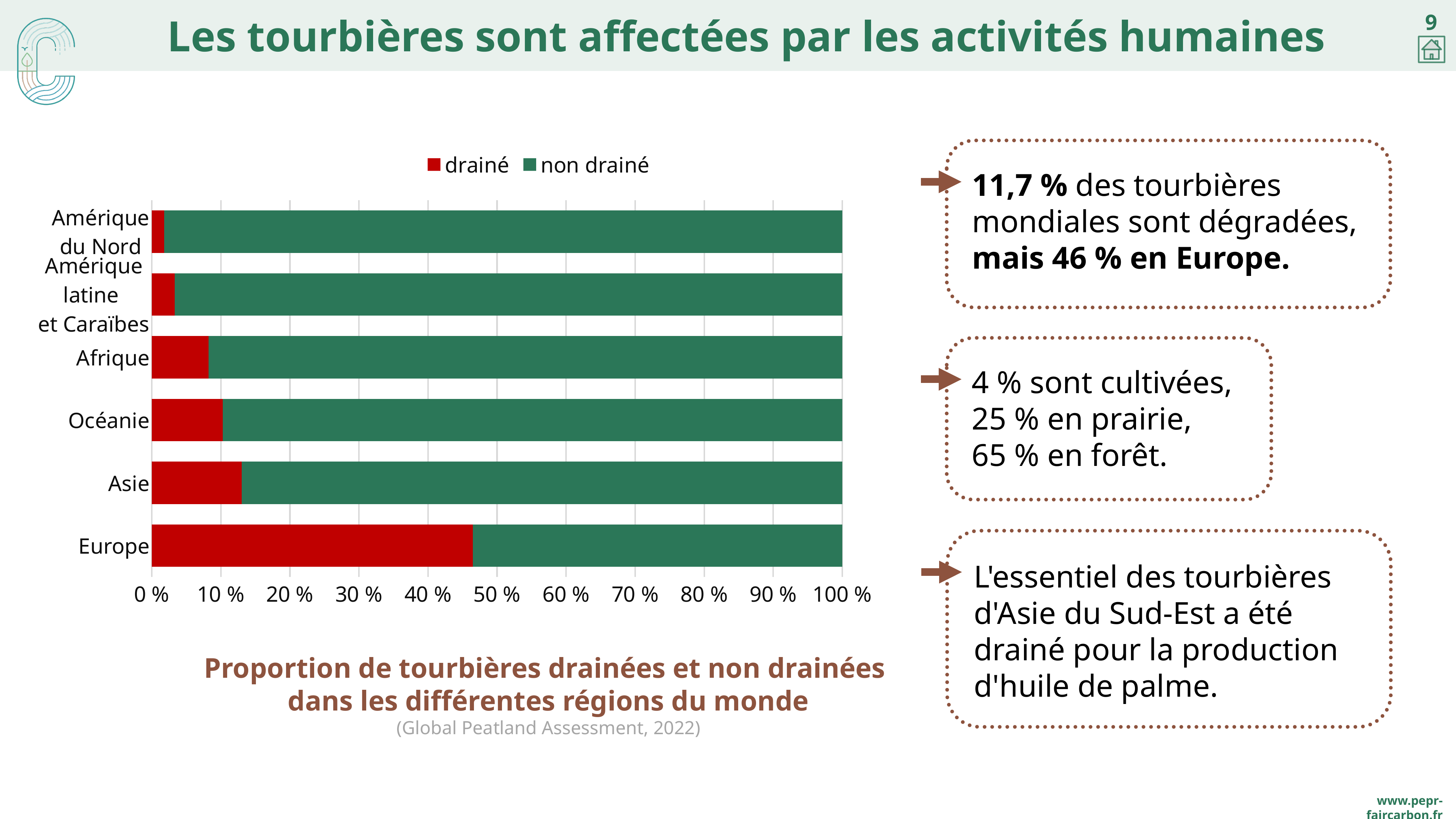
Which region has the lowest proportion of drained (drainé) peatlands? Amérique du Nord Which has a larger drained (drainé) share, Asie or Afrique? Asie What kind of chart is shown on the slide? Stacked bar chart Is the drained (drainé) share for Asie greater or less than 20 %? less How many series does the chart legend list? 2 Which region has the highest proportion of drained (drainé) peatlands? Europe Is the drained (drainé) share for Afrique greater or less than 10 %? less What is the total of the stacked bar for Europe? 100 % How many regions are listed on the chart? 6 What is the source cited below the chart? Global Peatland Assessment, 2022 Which has a larger non-drained (non drainé) share, Europe or Océanie? Océanie Is the drained (drainé) share for Europe greater or less than 40 %? greater